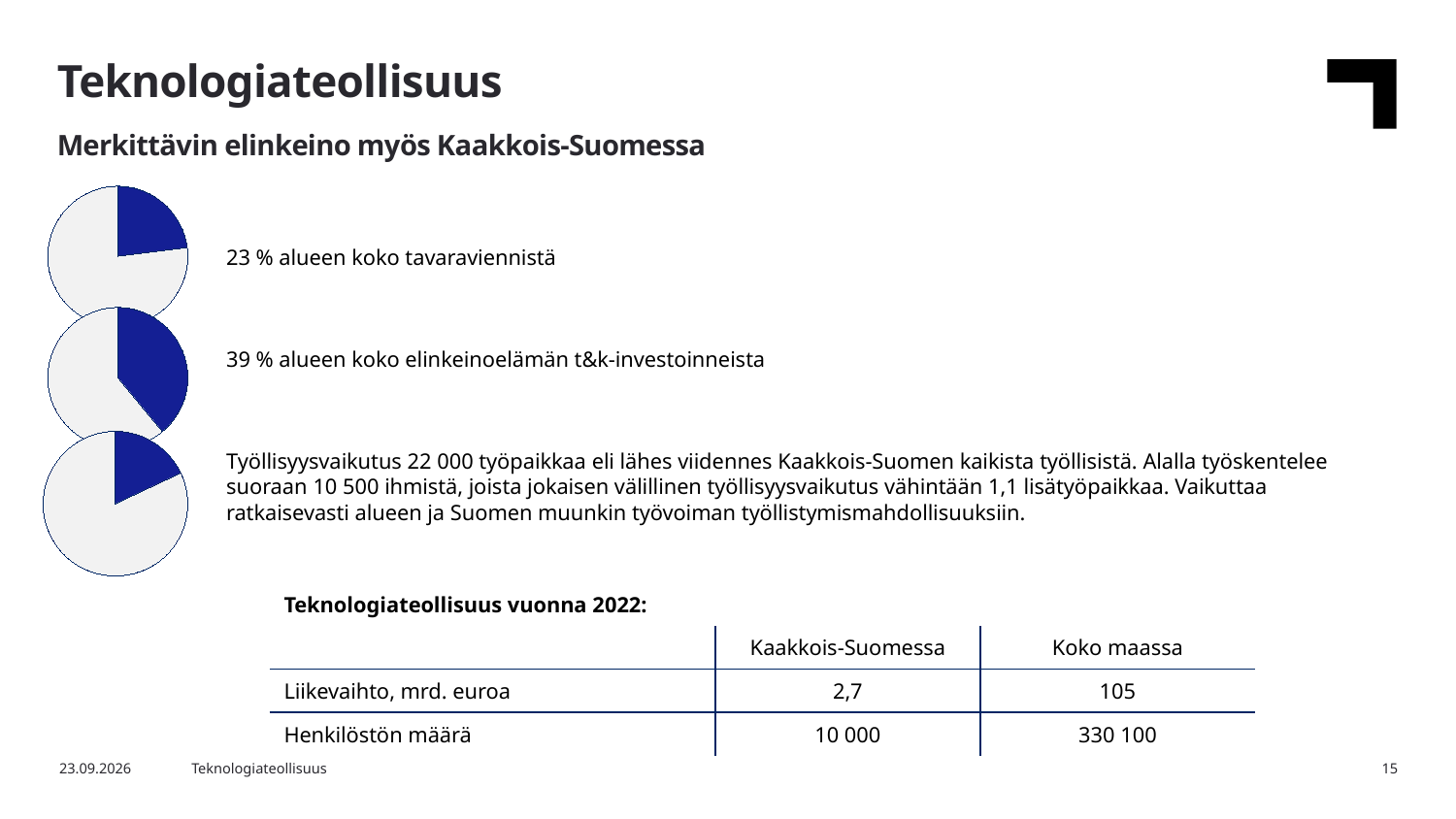
Which of the three pie charts has the largest blue slice? The middle one (39 % of t&k-investoinnit) Which pie chart has the larger blue slice, the middle one (t&k-investoinnit) or the bottom one (työllisyysvaikutus)? The middle one (t&k-investoinnit) What kind of charts are shown on the left side of the slide? Pie charts How many pie charts are on the slide? 3 What is the difference in percentage points between the blue slices of the middle pie chart (39 %) and the top pie chart (23 %)? 16 percentage points Which pie chart has the larger blue slice, the top one (tavaravienti) or the middle one (t&k-investoinnit)? The middle one (t&k-investoinnit) In the top pie chart, what share of the region's total goods exports (tavaravienti) does the blue slice represent? 23 % In the middle pie chart, what share of the region's business R&D investments (t&k-investoinnit) does the blue slice represent? 39 % What colour is the highlighted slice in each pie chart? Blue How many slices does each pie chart have? 2